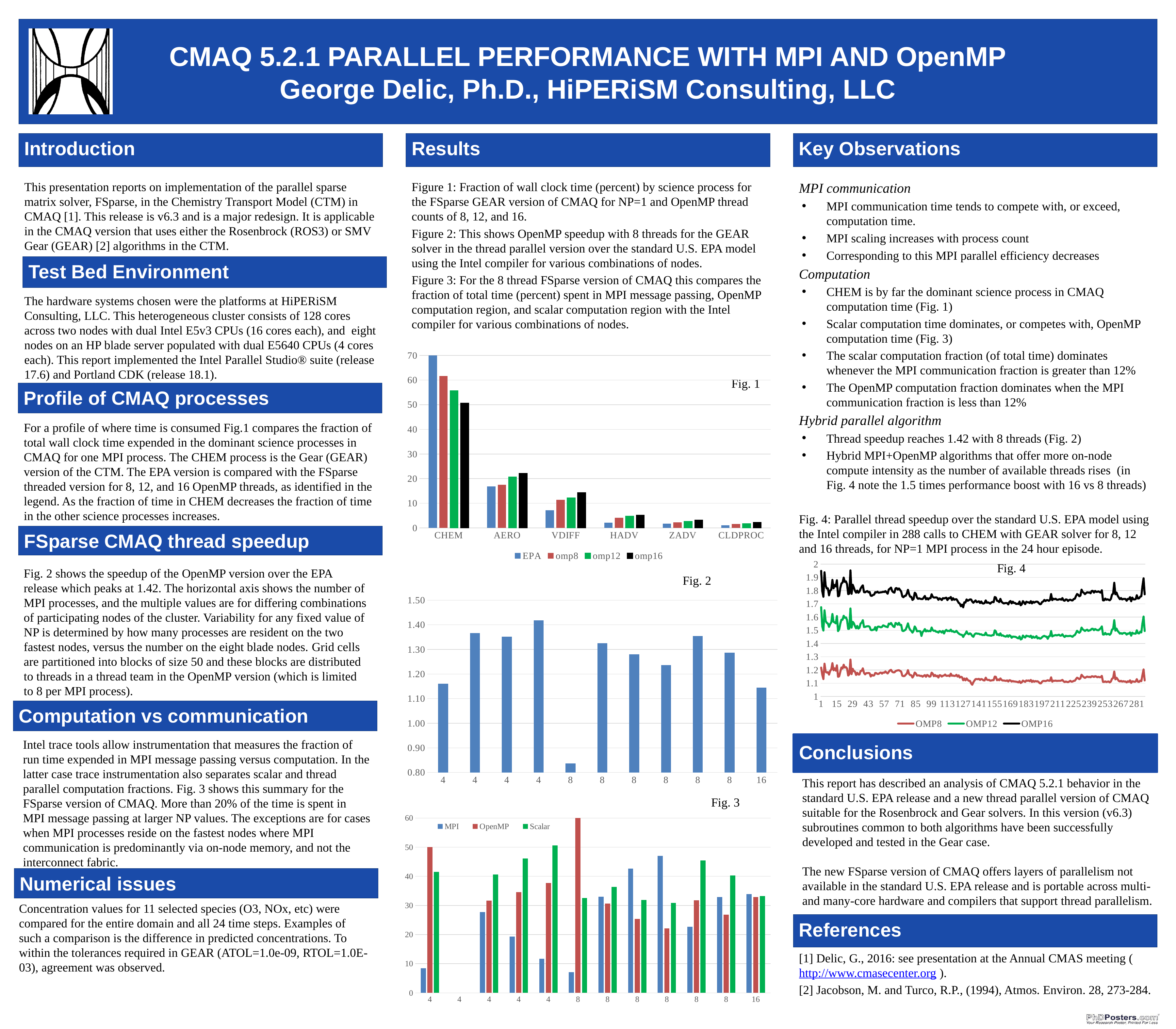
In Fig. 2, is the value of the first bar (labelled 4) greater or less than 1.10? greater In Fig. 4, which series has the highest values across the chart? OMP16 In Fig. 1, for CHEM, which is larger: the EPA value or the omp16 value? EPA In Fig. 1, how many series does the legend list? 4 In Fig. 1, what kind of chart is shown? bar chart In Fig. 1, how many science process categories are shown on the x axis? 6 In Fig. 3, is the MPI value for the first category (labelled 4) greater or less than 10? less In Fig. 1, which science process has the highest EPA value? CHEM In Fig. 2, how many bars are plotted? 11 In Fig. 1, is the EPA value for CHEM greater or less than 60? greater In Fig. 3, how many series does the legend list? 3